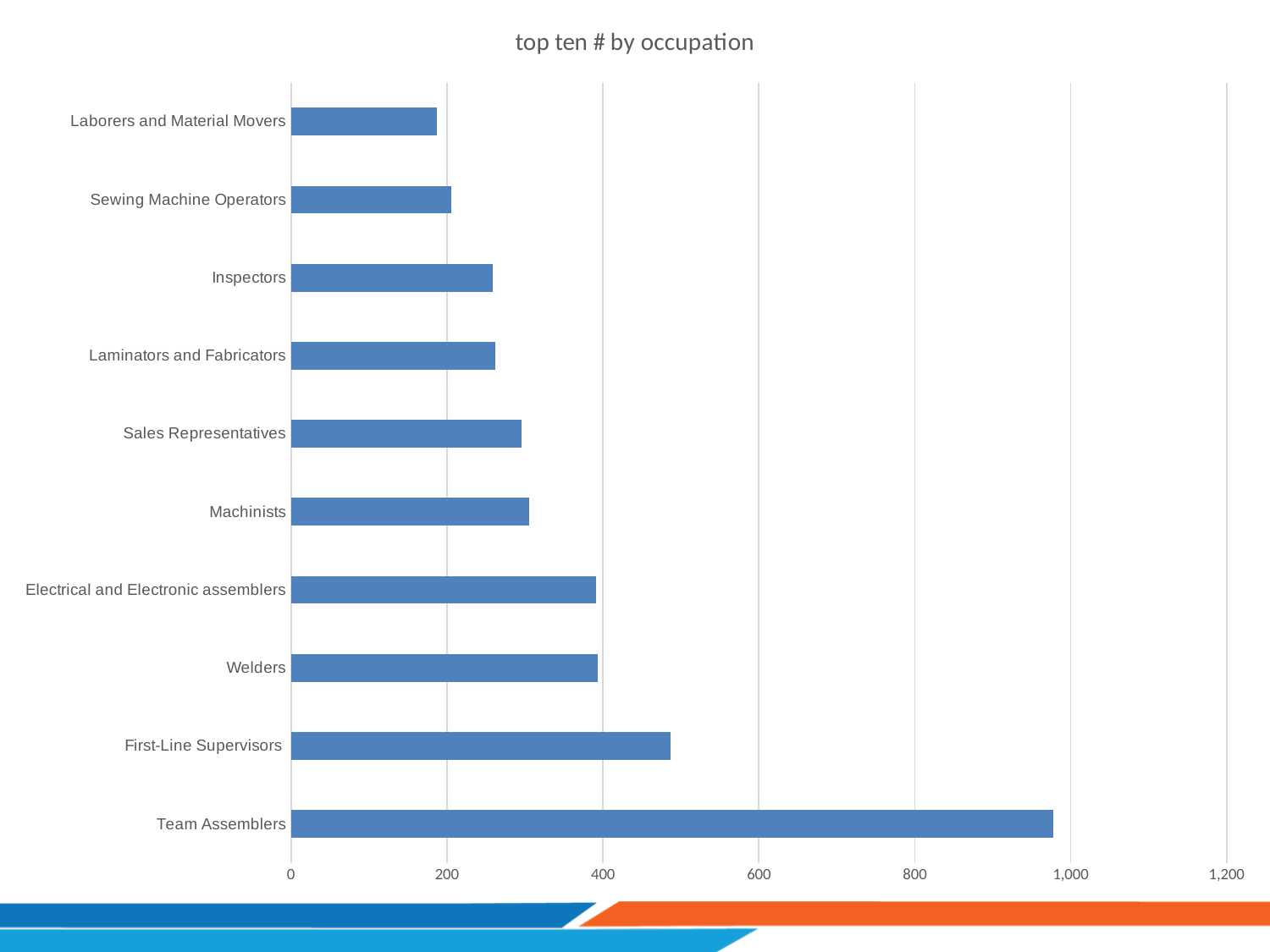
How many occupations are plotted in the chart? 10 Which is larger, the value for Team Assemblers or the value for First-Line Supervisors? Team Assemblers Is the value for Laborers and Material Movers greater or less than 200? less What type of chart is shown on the slide? bar chart Is the value for Team Assemblers greater or less than 800? greater Which occupation has the lowest value? Laborers and Material Movers Which occupation has the highest value? Team Assemblers Is the value for Sales Representatives greater or less than 400? less What is the title of the chart? top ten # by occupation What is the highest value shown on the horizontal axis? 1,200